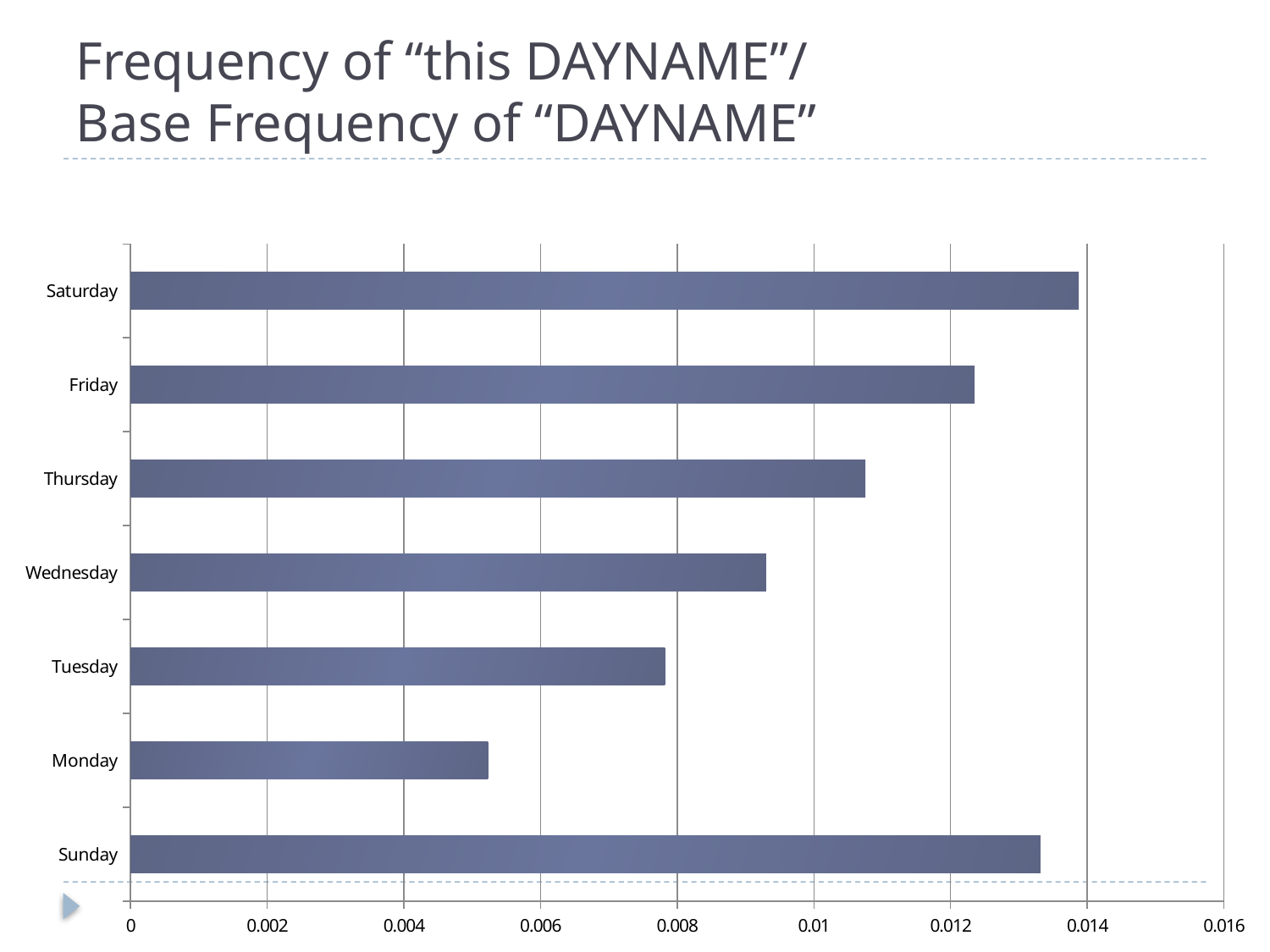
Which day has the highest value in the chart? Saturday Is the value for Monday greater or less than 0.006? less What is the title of the slide containing the chart? Frequency of "this DAYNAME"/ Base Frequency of "DAYNAME" How many days are plotted in the chart? 7 Is the value for Wednesday greater or less than 0.008? greater What kind of chart is shown on the slide? bar chart Which day has the lowest value in the chart? Monday Is the value for Thursday greater or less than 0.01? greater Which has the larger value, Sunday or Monday? Sunday Which has the larger value, Friday or Thursday? Friday